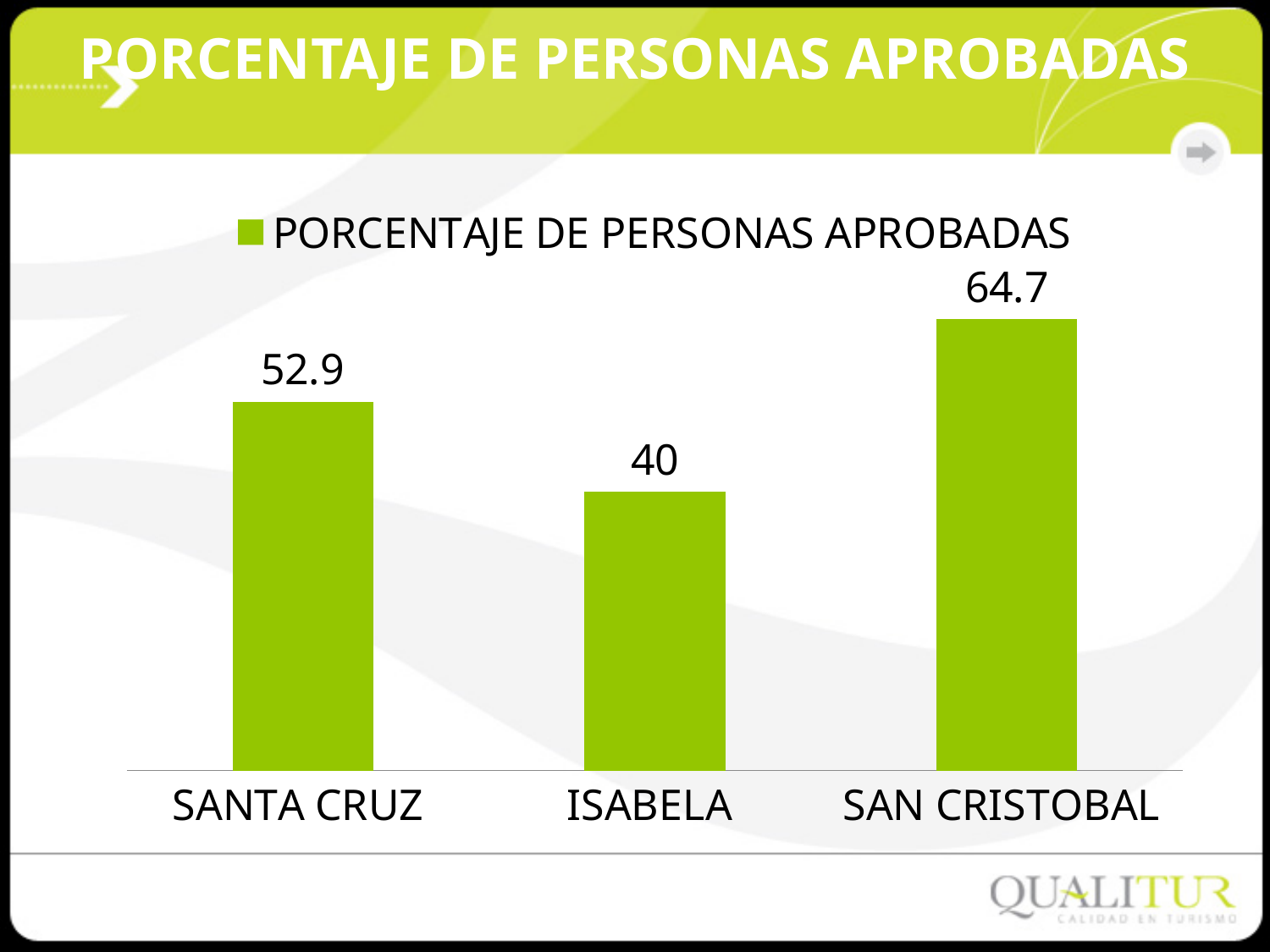
Which is larger, the value for SANTA CRUZ or the value for ISABELA? SANTA CRUZ What is the value for SANTA CRUZ? 52.9 How many series does the legend list? 1 What is the value for SAN CRISTOBAL? 64.7 Which category has the highest value? SAN CRISTOBAL What is the difference between the values for SAN CRISTOBAL and SANTA CRUZ? 11.8 What kind of chart is shown on the slide? bar chart What is the legend entry shown in the chart? PORCENTAJE DE PERSONAS APROBADAS How many categories are shown in the chart? 3 What is the value for ISABELA? 40 Which category has the lowest value? ISABELA What is the difference between the values for SANTA CRUZ and ISABELA? 12.9